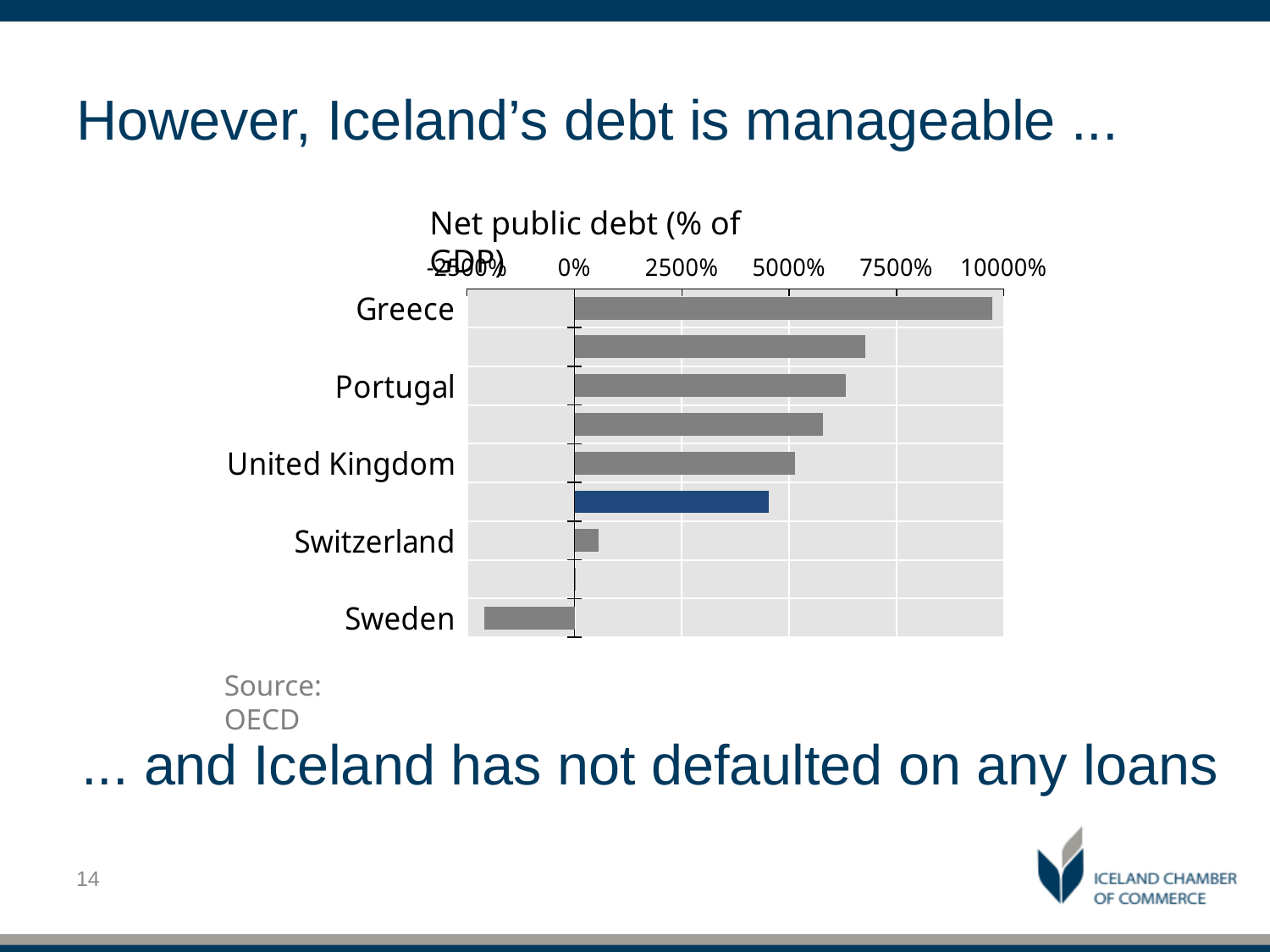
Is the value for United Kingdom greater or less than 7500%? less Is the value for Greece greater or less than 7500%? greater Is the value for Switzerland greater or less than 2500%? less Which labelled country has the highest net public debt in the chart? Greece Do the bar values rise or fall going from the top of the chart to the bottom? fall What kind of chart is shown on the slide? bar chart What is the title of the chart? Net public debt (% of GDP) Which labelled country has the lowest net public debt in the chart? Sweden Which has a larger net public debt, Switzerland or United Kingdom? United Kingdom Which has a larger net public debt, Greece or Portugal? Greece